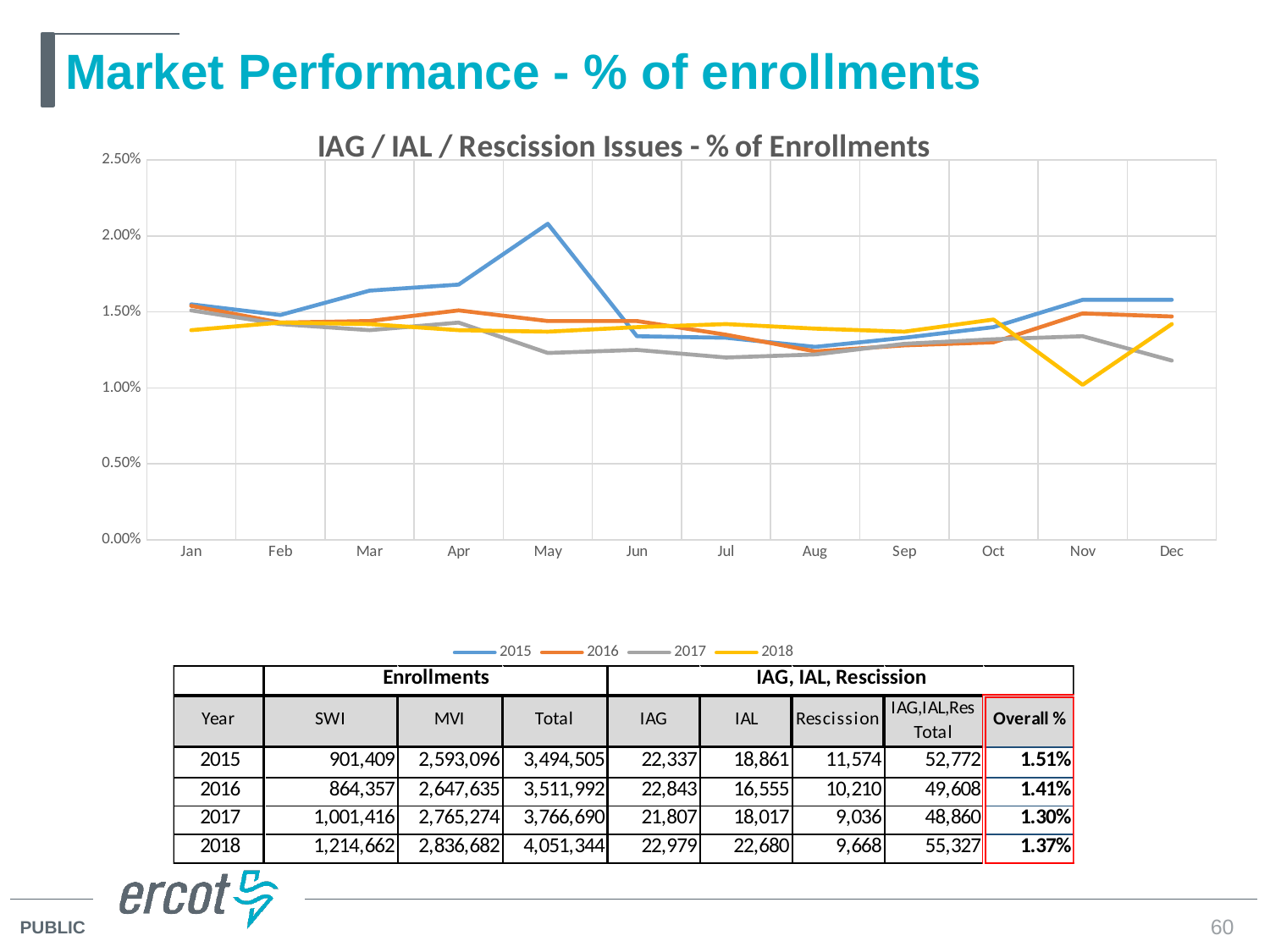
What is the title of the chart? IAG / IAL / Rescission Issues - % of Enrollments Does the 2015 series rise or fall from May to Jun? fall Is the value for 2015 in May greater or less than 2.00%? greater What kind of chart is shown on the slide? line chart Which is larger in May, the 2015 value or the 2017 value? 2015 In which month does the 2015 series reach its highest value? May Which series reaches the highest point on the chart? 2015 How many series does the chart legend list? 4 Is the value for 2017 in Dec greater or less than 1.50%? less In which month does the 2018 series reach its lowest value? Nov Which years are listed in the chart legend? 2015, 2016, 2017, 2018 How many months are plotted along the x axis of the chart? 12